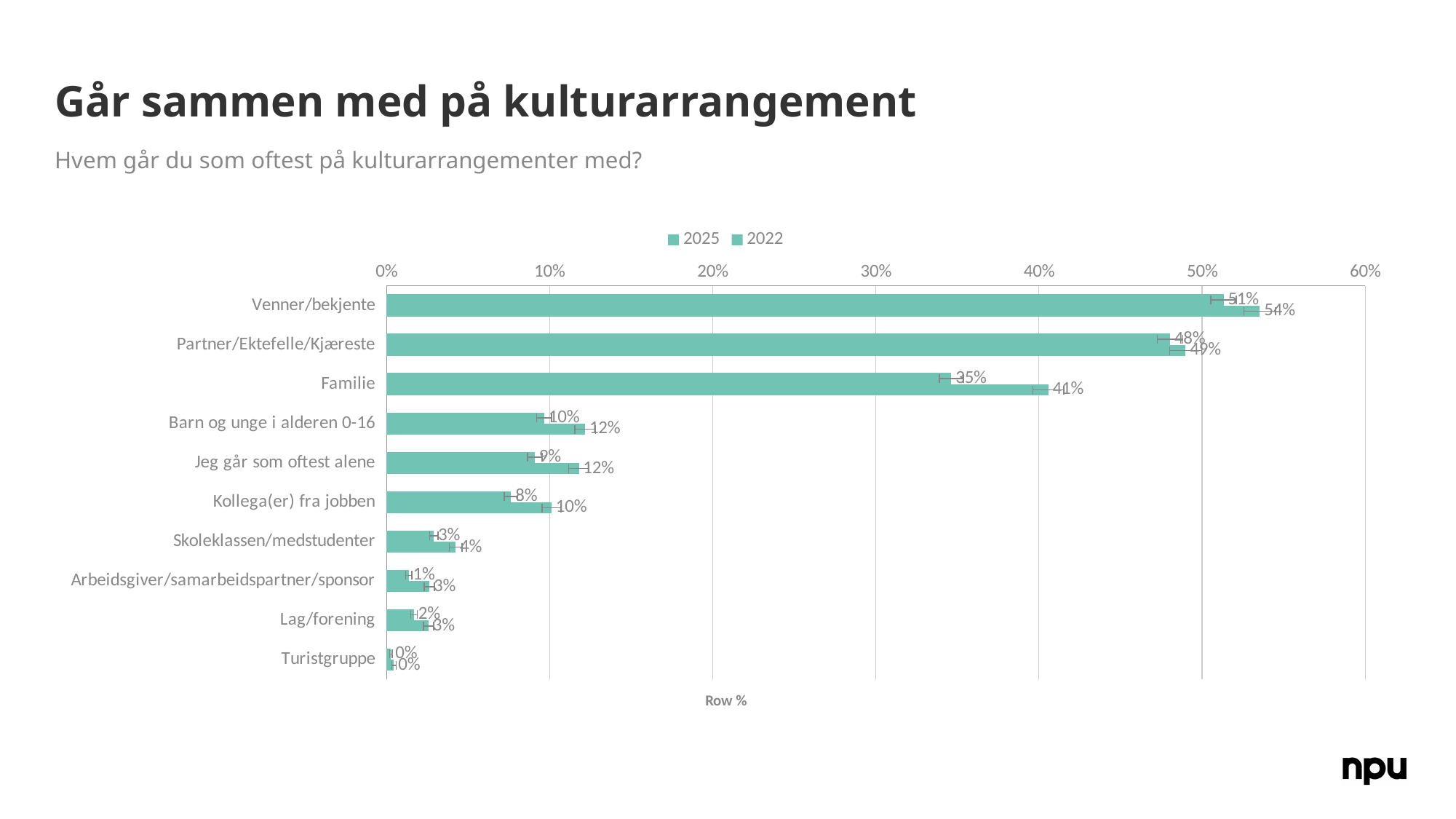
Is the 2025 value for Partner/Ektefelle/Kjæreste greater or less than 40%? greater What is the 2022 value for Venner/bekjente? 51% What kind of chart is shown on the slide? bar chart Which category has the highest value in 2022? Venner/bekjente How many categories are shown on the chart? 10 What is the 2025 value for Familie? 41% What is the difference between the 2022 and 2025 values for Familie? 6% What is the label on the horizontal axis of the chart? Row % What is the 2022 value for Kollega(er) fra jobben? 8% Which is larger for Barn og unge i alderen 0-16: the 2025 value or the 2022 value? 2025 How many series does the legend list? 2 Which category has the lowest value in 2025? Turistgruppe